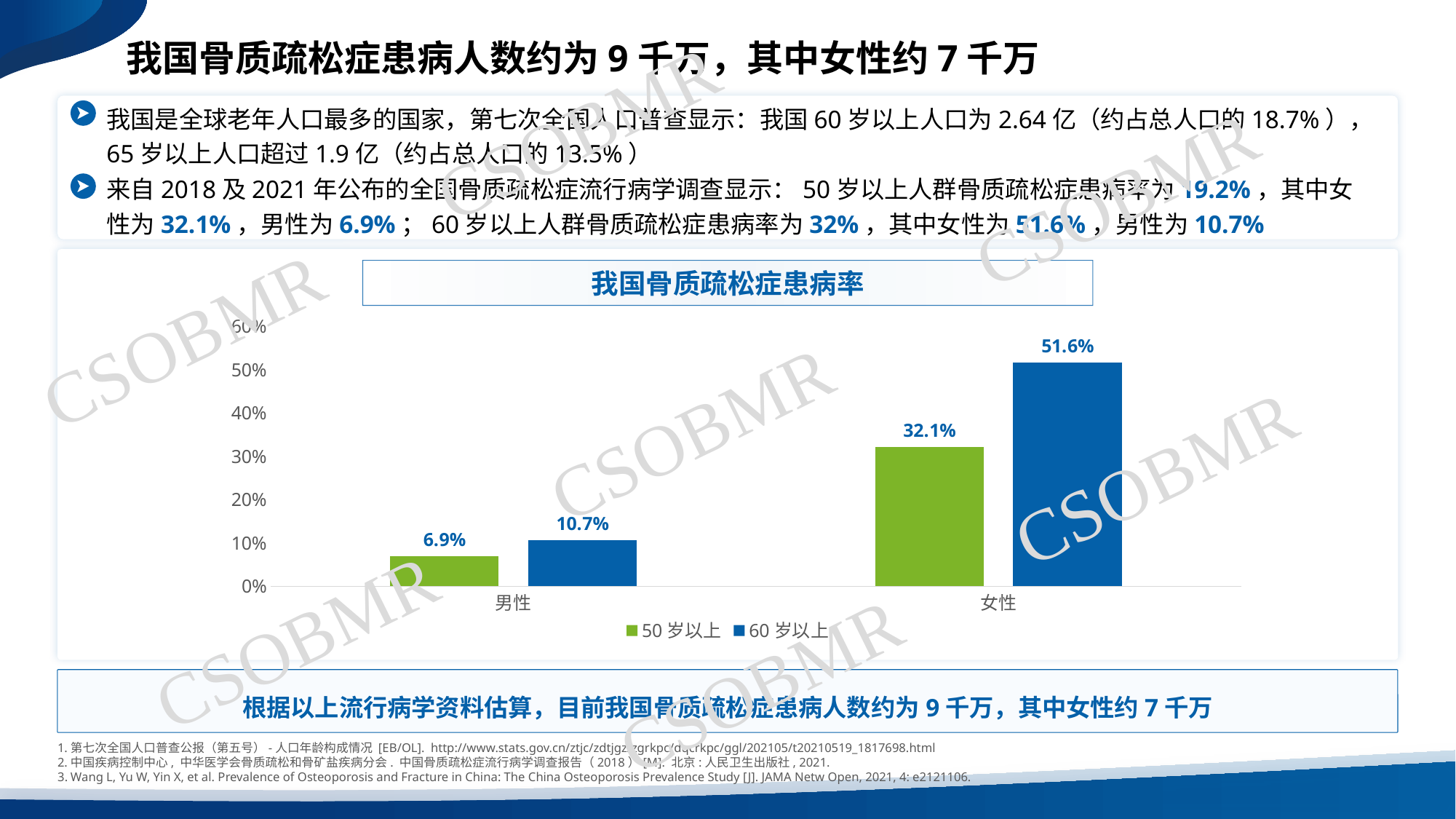
How many categories are shown on the x axis of the chart? 2 What is the value for 男性 in the 50 岁以上 series? 6.9% What is the value for 女性 in the 50 岁以上 series? 32.1% How many series does the chart legend list? 2 Which bar has the highest value in the chart? 女性, 60 岁以上 What is the value for 男性 in the 60 岁以上 series? 10.7% What is the value for 女性 in the 60 岁以上 series? 51.6% Which bar has the lowest value in the chart? 男性, 50 岁以上 Which series is shown in green in the chart? 50 岁以上 What is the difference between the 60 岁以上 and 50 岁以上 values for 女性? 19.5% What is the title of the chart? 我国骨质疏松症患病率 What type of chart is shown on the slide? bar chart